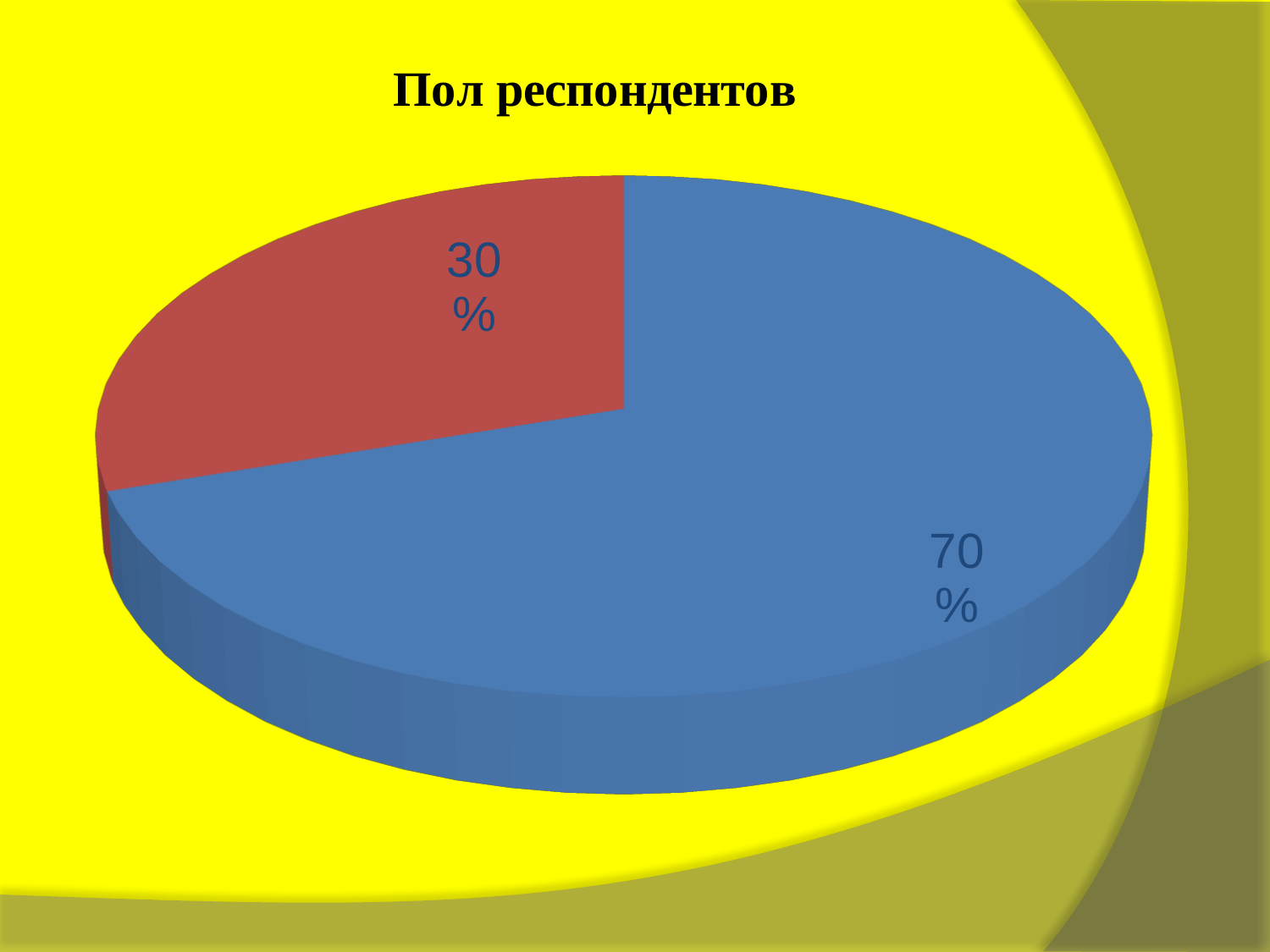
Which slice of the pie chart is the largest? the blue slice (70%) How many slices does the pie chart have? 2 What kind of chart is shown on the slide? pie chart What is the difference between the blue slice and the red slice? 40% What do the two slices of the pie chart add up to? 100% What percentage is shown on the red slice of the pie chart? 30% What share of the pie does the blue slice represent? 70% What is the title of the chart? Пол респондентов Is the value of the red slice greater or less than 50%? less What percentage is shown on the blue slice of the pie chart? 70% Which is larger, the blue slice or the red slice? the blue slice Which slice of the pie chart is the smallest? the red slice (30%)